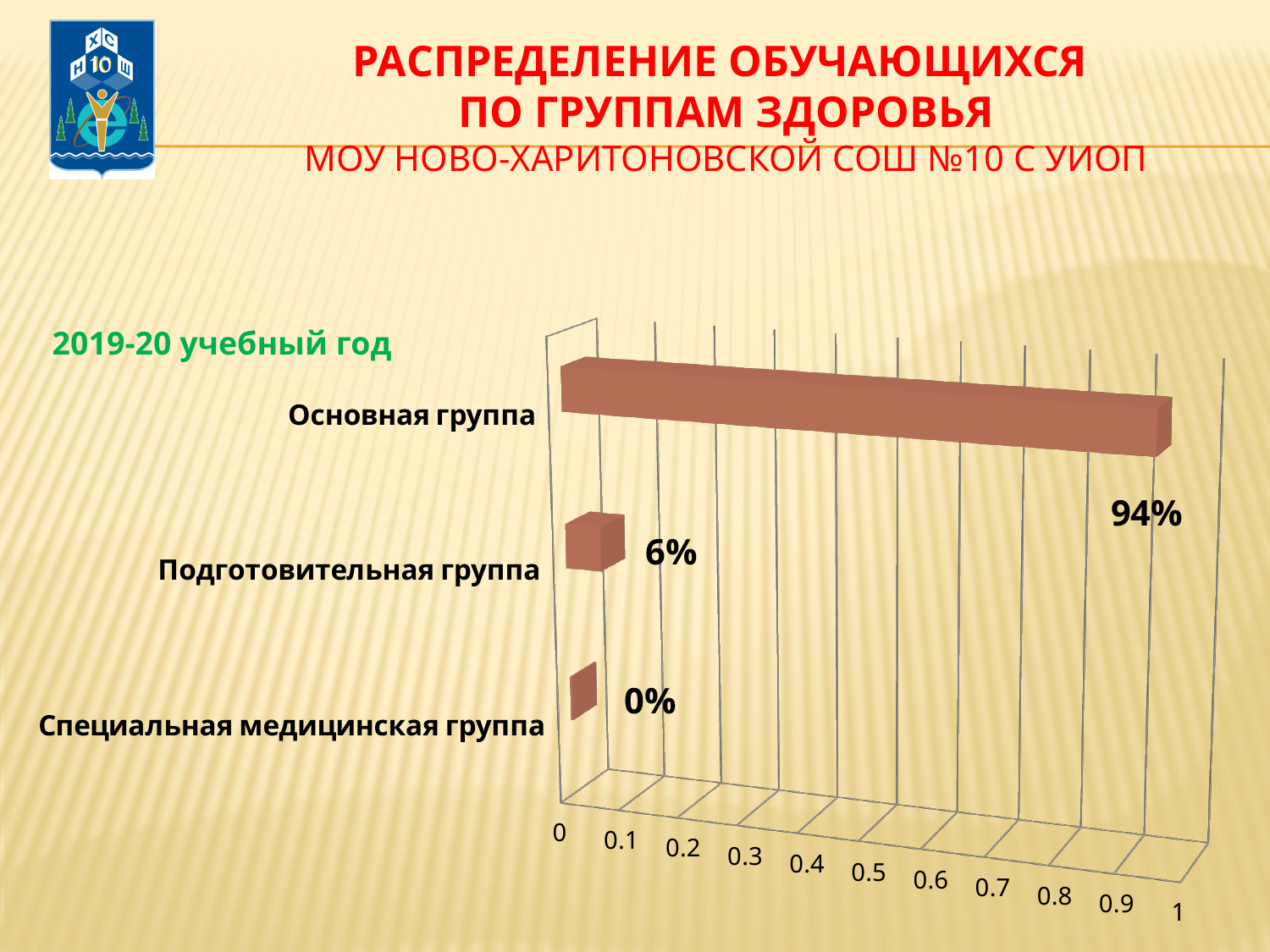
What is the total of the three values shown in the chart? 100% What is the value for Подготовительная группа? 6% What is the difference between the values for Основная группа and Подготовительная группа? 88% Which category has the highest value? Основная группа What is the value for Специальная медицинская группа? 0% Which category has the lowest value? Специальная медицинская группа What is the value for Основная группа? 94% What kind of chart is shown on the slide? bar chart Is the value for Основная группа greater or less than 0.5? greater Which is larger, the value for Подготовительная группа or the value for Специальная медицинская группа? Подготовительная группа How many categories are shown in the chart? 3 Which school year is the chart labelled with? 2019-20 учебный год